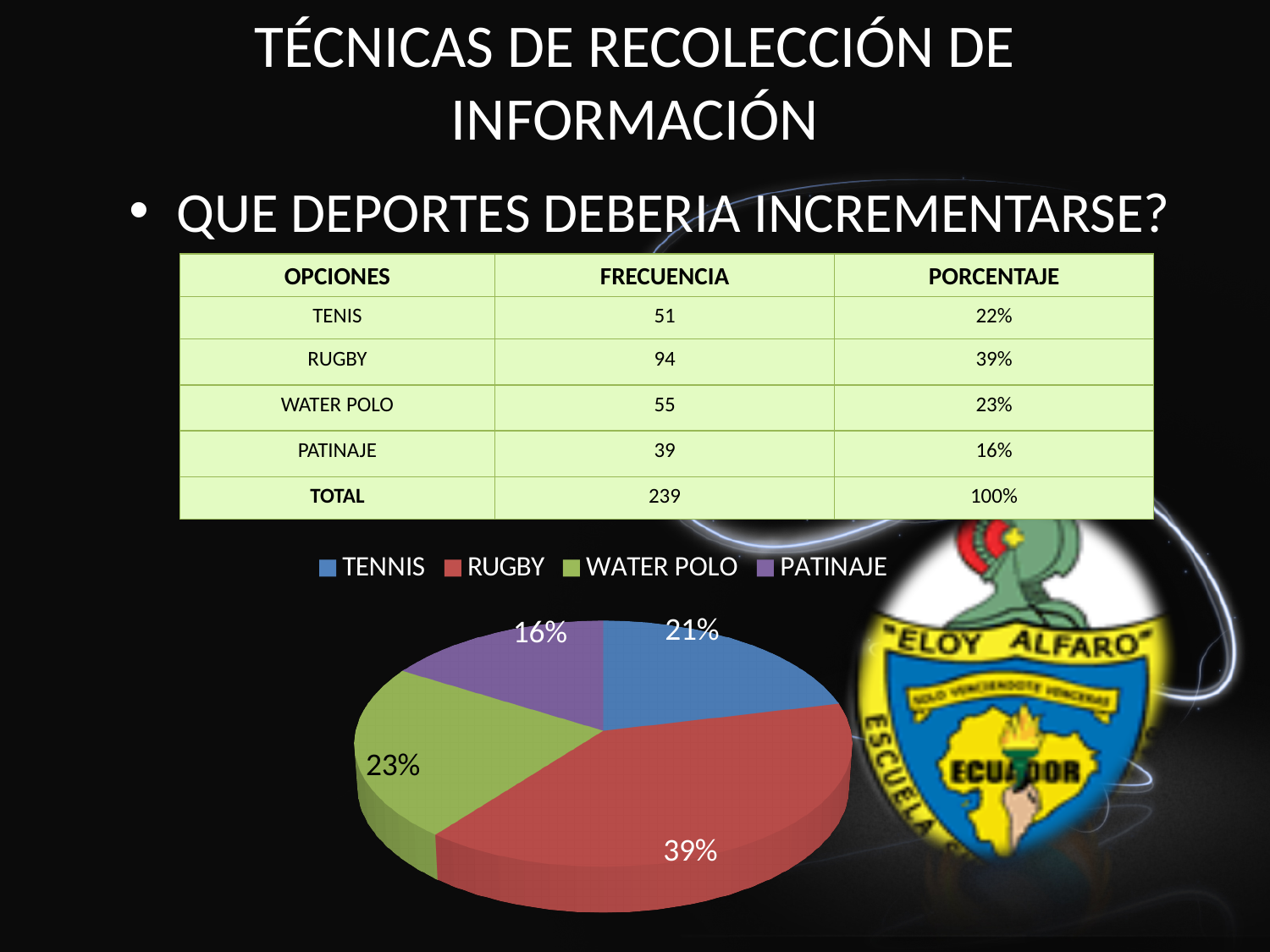
Which category has the largest slice in the pie chart? RUGBY How many slices does the pie chart have? 4 How many entries does the pie chart legend list? 4 Which category has the smallest slice in the pie chart? PATINAJE What percentage does the pie chart show for PATINAJE? 16% In the pie chart, which slice is larger, WATER POLO or PATINAJE? WATER POLO What is the difference in percentage points between the RUGBY and PATINAJE slices in the pie chart? 23 What colour is the RUGBY slice in the pie chart? red What percentage does the pie chart show for WATER POLO? 23% What kind of chart is shown on the slide? pie chart What percentage does the pie chart show for TENNIS? 21% What percentage does the pie chart show for RUGBY? 39%